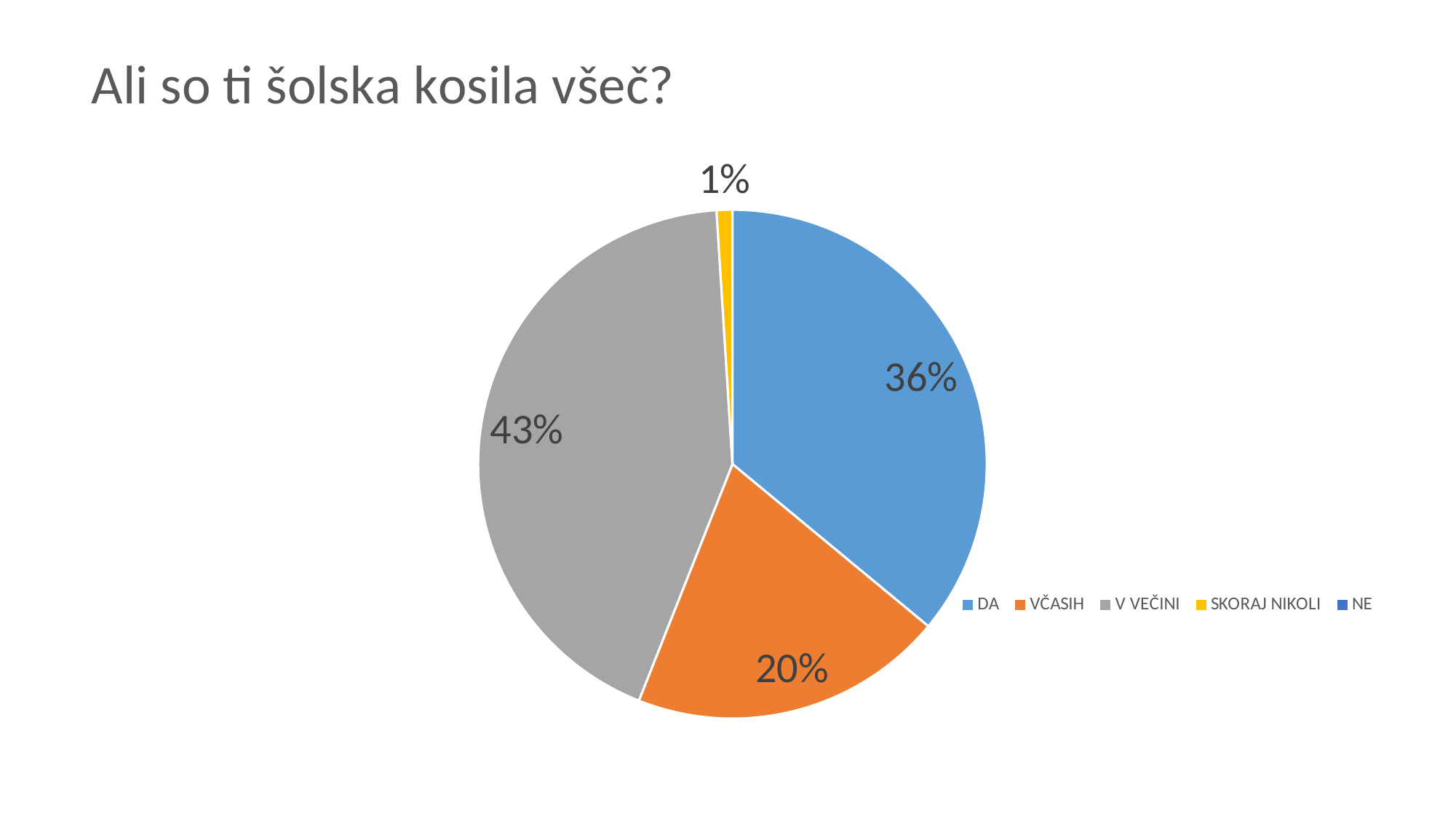
How many entries does the legend list? 5 What is the difference between the DA and VČASIH percentages? 16% How many percentage points larger is V VEČINI than DA? 7% Which slice has the smallest printed percentage? SKORAJ NIKOLI What is the title of the slide? Ali so ti šolska kosila všeč? Which is larger, the DA slice or the VČASIH slice? DA Which category has the largest slice of the pie? V VEČINI What percentage is shown for V VEČINI? 43% What percentage is shown for SKORAJ NIKOLI? 1% What percentage is shown for VČASIH? 20% What percentage of the pie is the DA slice? 36% What kind of chart is shown on the slide? Pie chart